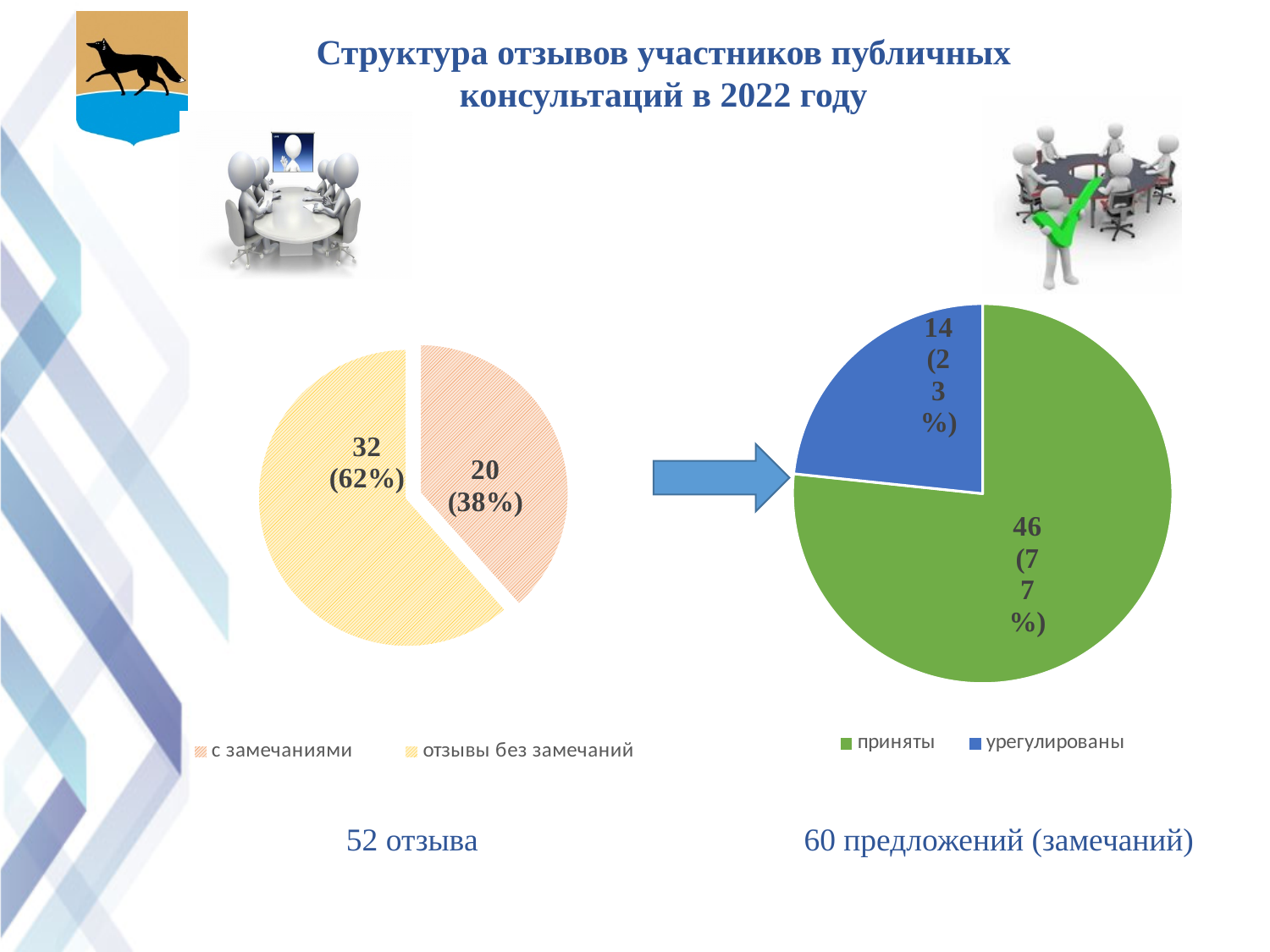
In the right pie chart, which slice is the smallest? урегулированы How many entries does the legend of the left pie chart list? 2 In the left pie chart, which slice is the largest? отзывы без замечаний In the right pie chart, what is the difference between the count for 'приняты' and the count for 'урегулированы'? 32 In the right pie chart, what value is shown for the slice 'приняты'? 46 (77%) In the right pie chart, what value is shown for the slice 'урегулированы'? 14 (23%) In the left pie chart, what share of the pie does the 'с замечаниями' slice represent? 38% What type of chart is the chart on the right side of the slide? Pie chart In the left pie chart, what value is shown for the slice 'с замечаниями'? 20 (38%) In the left pie chart, what value is shown for the slice 'отзывы без замечаний'? 32 (62%) In the right pie chart, what share of the pie does the 'приняты' slice represent? 77% In the left pie chart, what is the difference between the count for 'отзывы без замечаний' and the count for 'с замечаниями'? 12